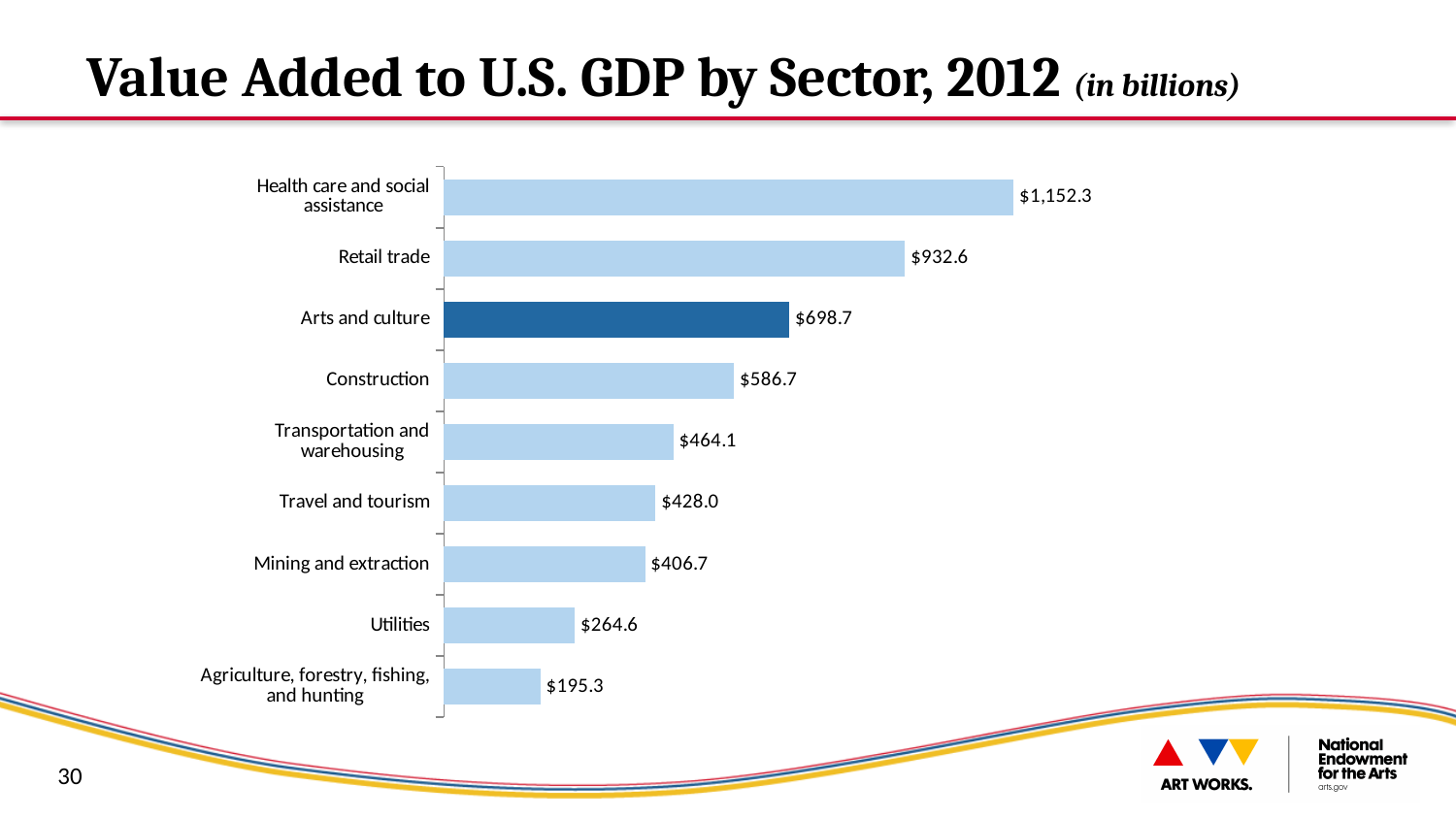
What is the value shown for Retail trade? $932.6 What kind of chart is shown on the slide? Bar chart What is the difference between the values for Health care and social assistance and Retail trade? $219.7 Which is larger, the value for Travel and tourism or the value for Mining and extraction? Travel and tourism What is the difference between the values for Arts and culture and Construction? $112.0 What is the value added to U.S. GDP by the Arts and culture sector? $698.7 Which sector has the highest value added to U.S. GDP? Health care and social assistance What is the title of the chart? Value Added to U.S. GDP by Sector, 2012 (in billions) Which bar is highlighted in a darker blue than the others? Arts and culture Which sector has the lowest value added to U.S. GDP? Agriculture, forestry, fishing, and hunting How many sectors are shown in the chart? 9 What is the value shown for Utilities? $264.6